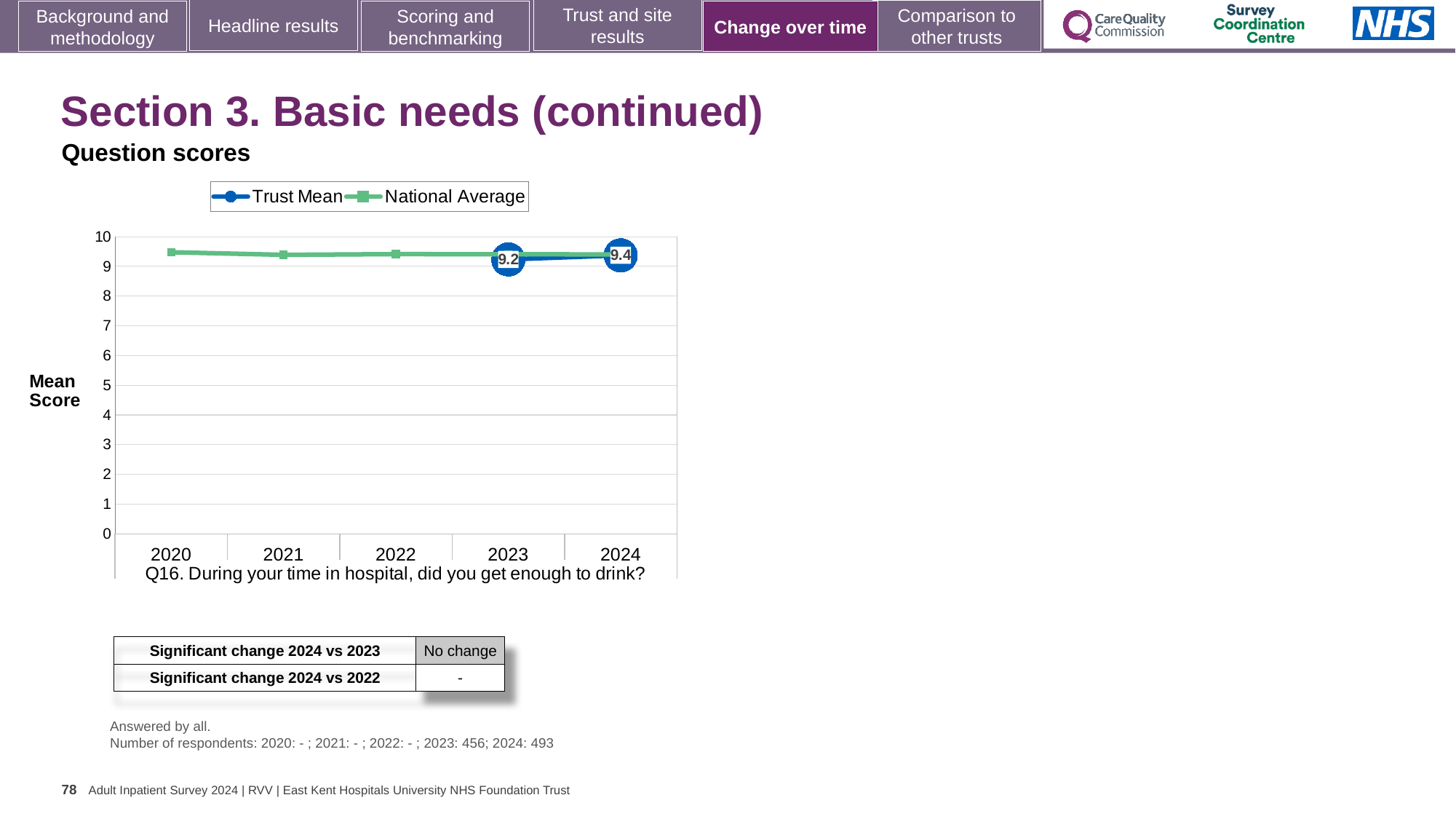
Is the National Average value for 2020 greater or less than 8? greater What is the label on the y axis of the chart? Mean Score What kind of chart is shown on the slide? line chart Which year has the higher Trust Mean score, 2023 or 2024? 2024 Is the Trust Mean value for 2023 greater or less than 5? greater How many years are shown on the x axis? 5 How many series does the legend list? 2 By how much did the Trust Mean score change from 2023 to 2024? 0.2 What is the Trust Mean score for 2024? 9.4 Does the Trust Mean score rise or fall from 2023 to 2024? rise What is the Trust Mean score for 2023? 9.2 Which series are listed in the chart legend? Trust Mean, National Average